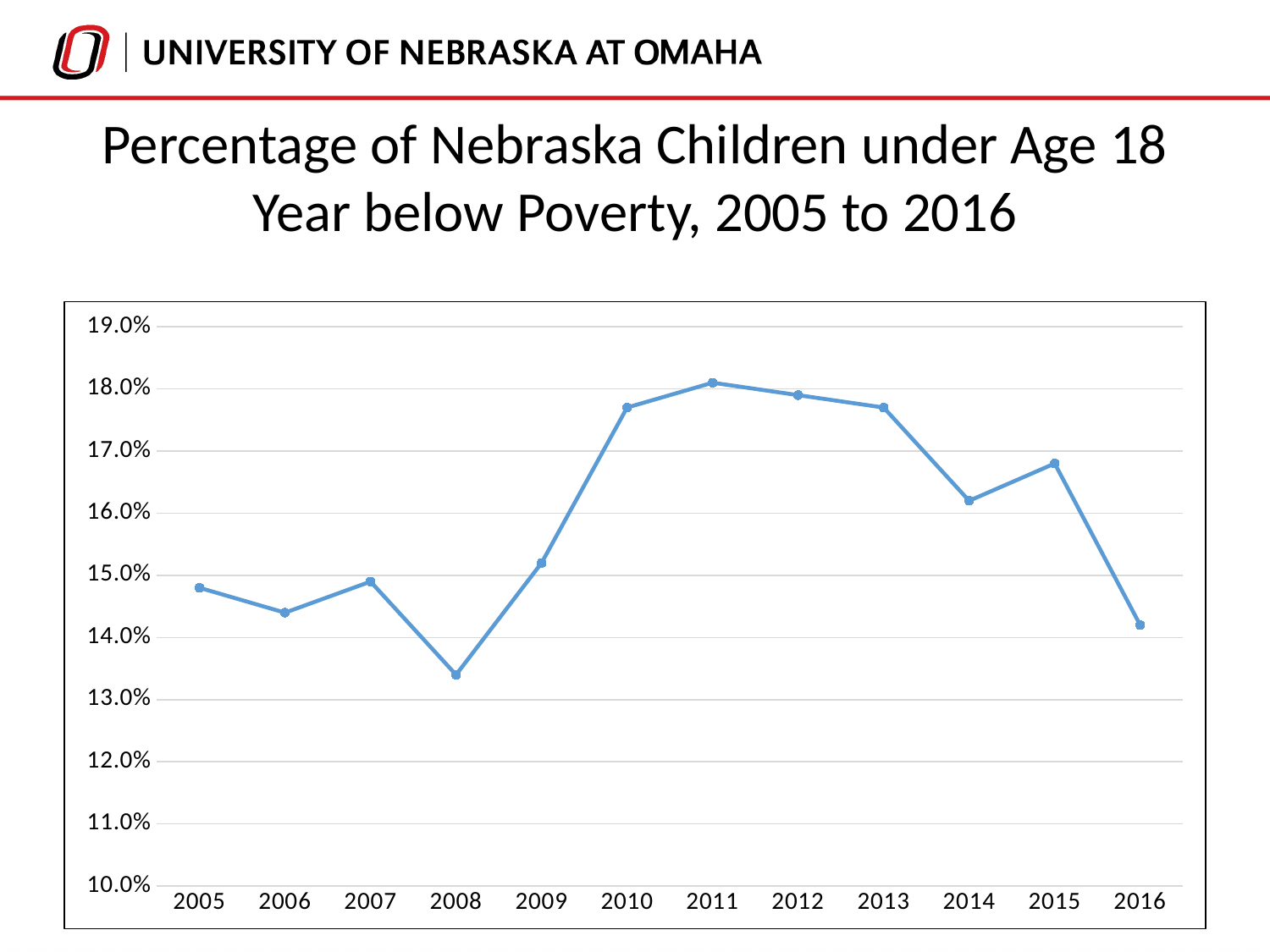
Which year has the larger value, 2010 or 2016? 2010 Which year has the larger value, 2014 or 2015? 2015 Which year has the highest percentage of children below poverty? 2011 Is the value for 2010 greater or less than 17.0%? greater What kind of chart is shown on the slide? line chart Is the value for 2008 greater or less than 14.0%? less What is the title of the chart on the slide? Percentage of Nebraska Children under Age 18 Year below Poverty, 2005 to 2016 Is the value for 2016 greater or less than 15.0%? less How many years are plotted on the x axis? 12 Which year has the lowest percentage of children below poverty? 2008 Does the percentage rise or fall from 2008 to 2011? rise